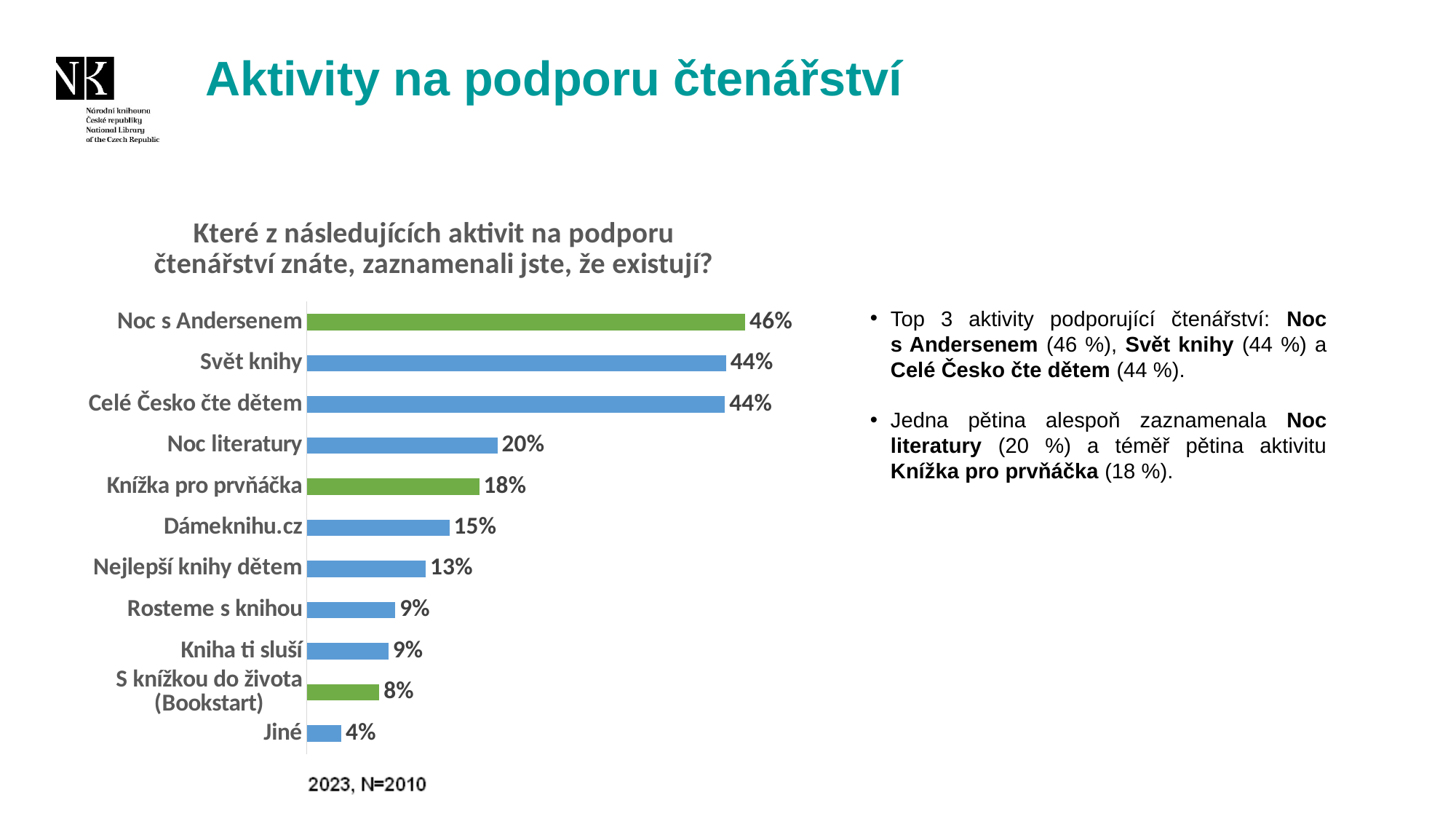
What is the difference between the values for Noc s Andersenem and Knížka pro prvňáčka? 28% What is the value for S knížkou do života (Bookstart)? 8% Which category has the highest value? Noc s Andersenem What is the value for Noc s Andersenem? 46% What is the value for Dámeknihu.cz? 15% What kind of chart is shown on the slide? Bar chart How many categories are shown in the chart? 11 Which category has the lowest value? Jiné What is the difference between the values for Noc literatury and Nejlepší knihy dětem? 7% What is the value for Noc literatury? 20% Which is larger, the value for Dámeknihu.cz or the value for Rosteme s knihou? Dámeknihu.cz What colour is the bar for Knížka pro prvňáčka? Green